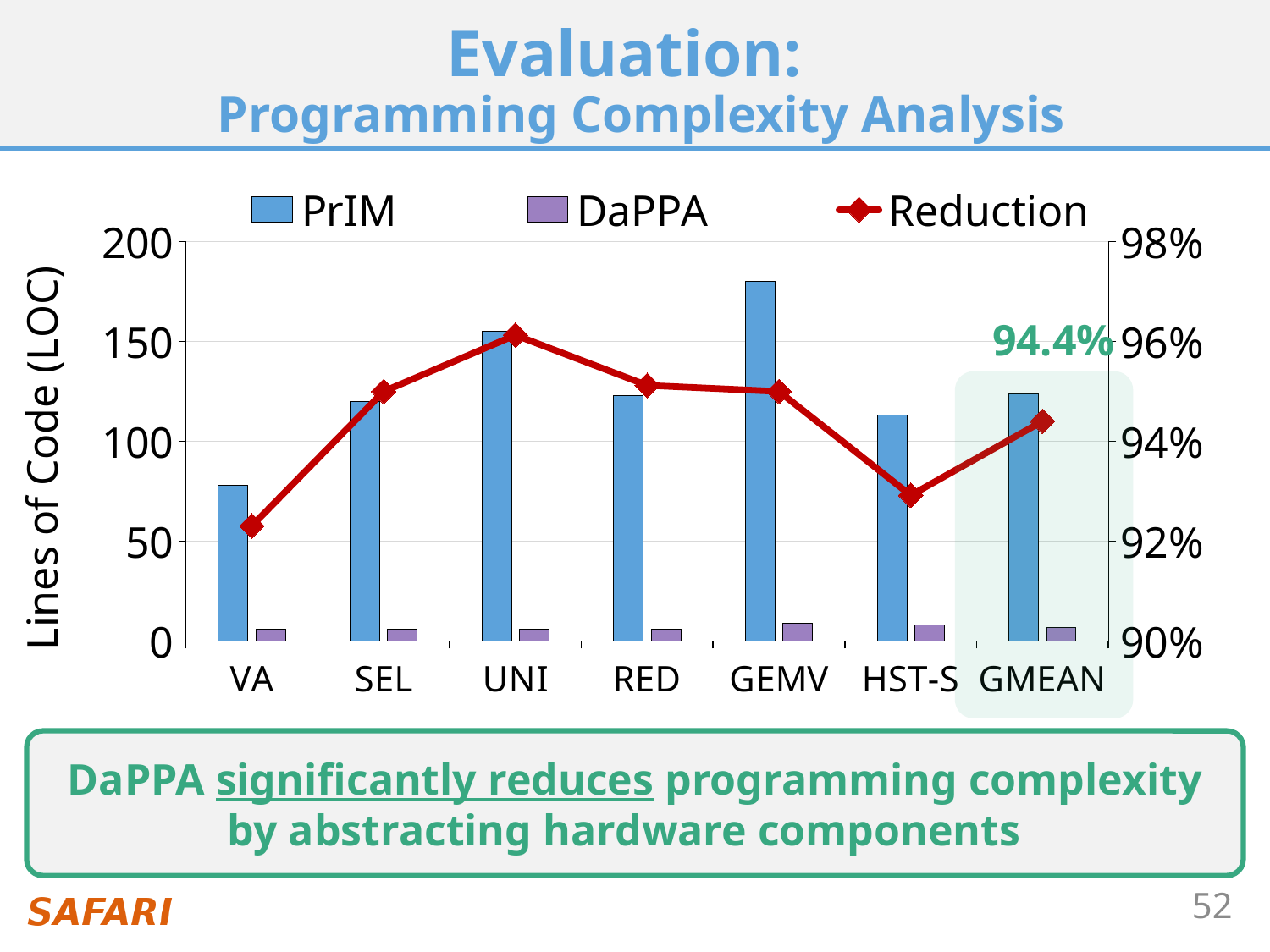
Is the Reduction value for VA greater or less than 94%? less Is the PrIM value for GEMV greater or less than 150? greater What kind of chart is shown on the slide? bar and line chart Which category has the highest Reduction percentage? UNI How many series does the legend list? 3 Is the PrIM value for VA greater or less than 100? less Which has more PrIM lines of code, GEMV or UNI? GEMV What is the Reduction value shown for GMEAN? 94.4% What is the title of the left vertical axis? Lines of Code (LOC) Which category has the highest PrIM lines of code? GEMV How many categories are shown on the x axis? 7 Which category has the lowest PrIM lines of code? VA